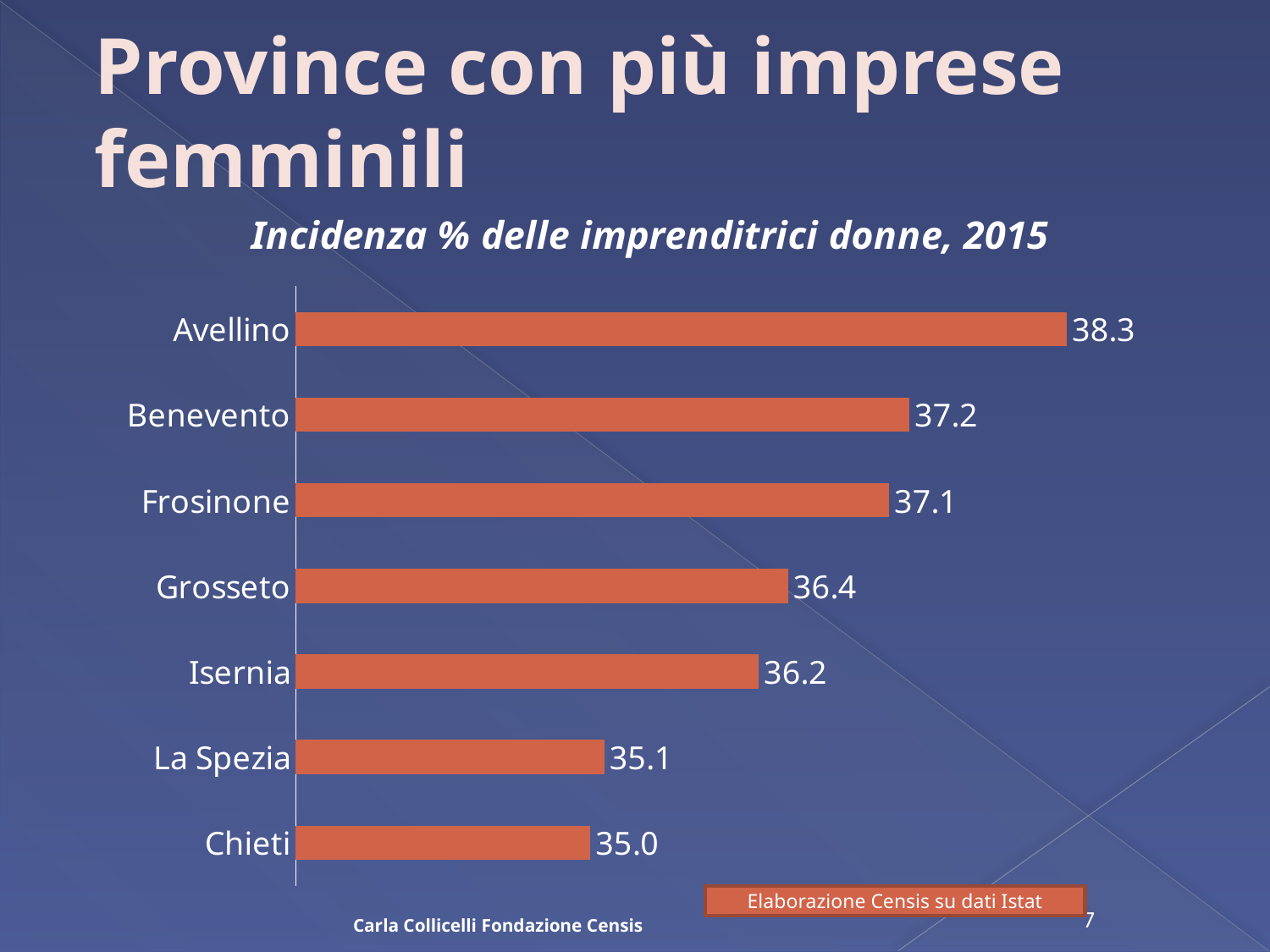
What is the subtitle of the chart? Incidenza % delle imprenditrici donne, 2015 What kind of chart is shown on the slide? bar chart What is the difference between the values for Avellino and Chieti? 3.3 What is the value for Frosinone? 37.1 What is the value for Grosseto? 36.4 Which is larger, the value for Grosseto or the value for La Spezia? Grosseto How many provinces are shown in the chart? 7 Which province has the highest value? Avellino What is the value for Avellino? 38.3 What is the difference between the values for Benevento and Isernia? 1.0 What is the value for Chieti? 35.0 Which province has the lowest value? Chieti